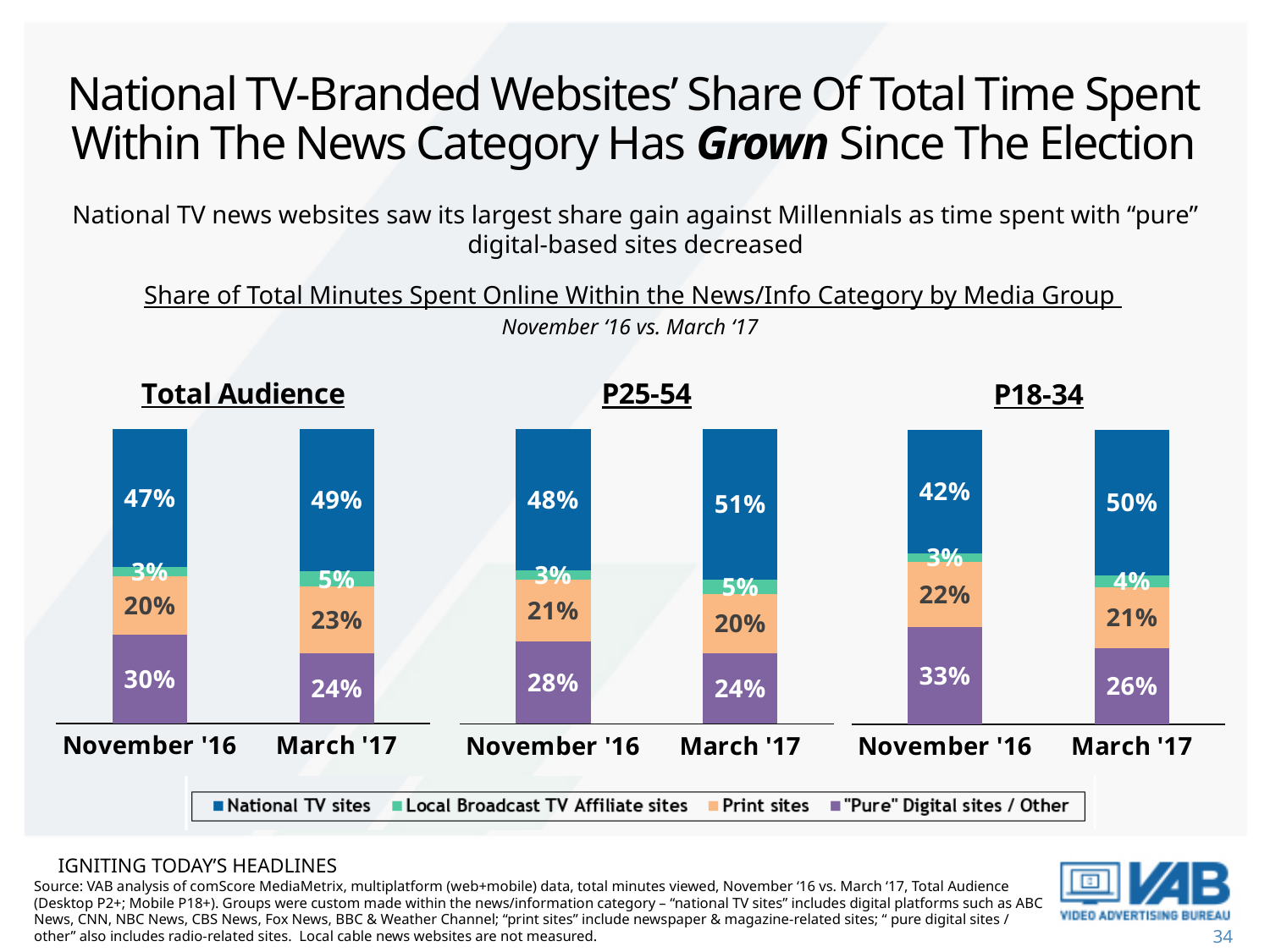
How many bars are shown in the P25-54 chart? 2 In the Total Audience chart, what is the total of the four segments in the March '17 bar? 101% In the P25-54 chart, which segment is the smallest in the March '17 bar? Local Broadcast TV Affiliate sites In the P25-54 chart, what share did Print sites have in March '17? 20% In the Total Audience chart, which segment is the largest in the November '16 bar? National TV sites In the P18-34 chart, what share did "Pure" Digital sites / Other have in November '16? 33% In the P18-34 chart, is the "Pure" Digital sites / Other share larger in November '16 or March '17? November '16 Which colour represents Print sites in the legend? Orange What type of chart is used for the Total Audience data? Stacked bar chart How many series does the legend list? 4 In the Total Audience chart, what share did National TV sites have in March '17? 49% In the P18-34 chart, by how many percentage points did the National TV sites share change from November '16 to March '17? 8 percentage points